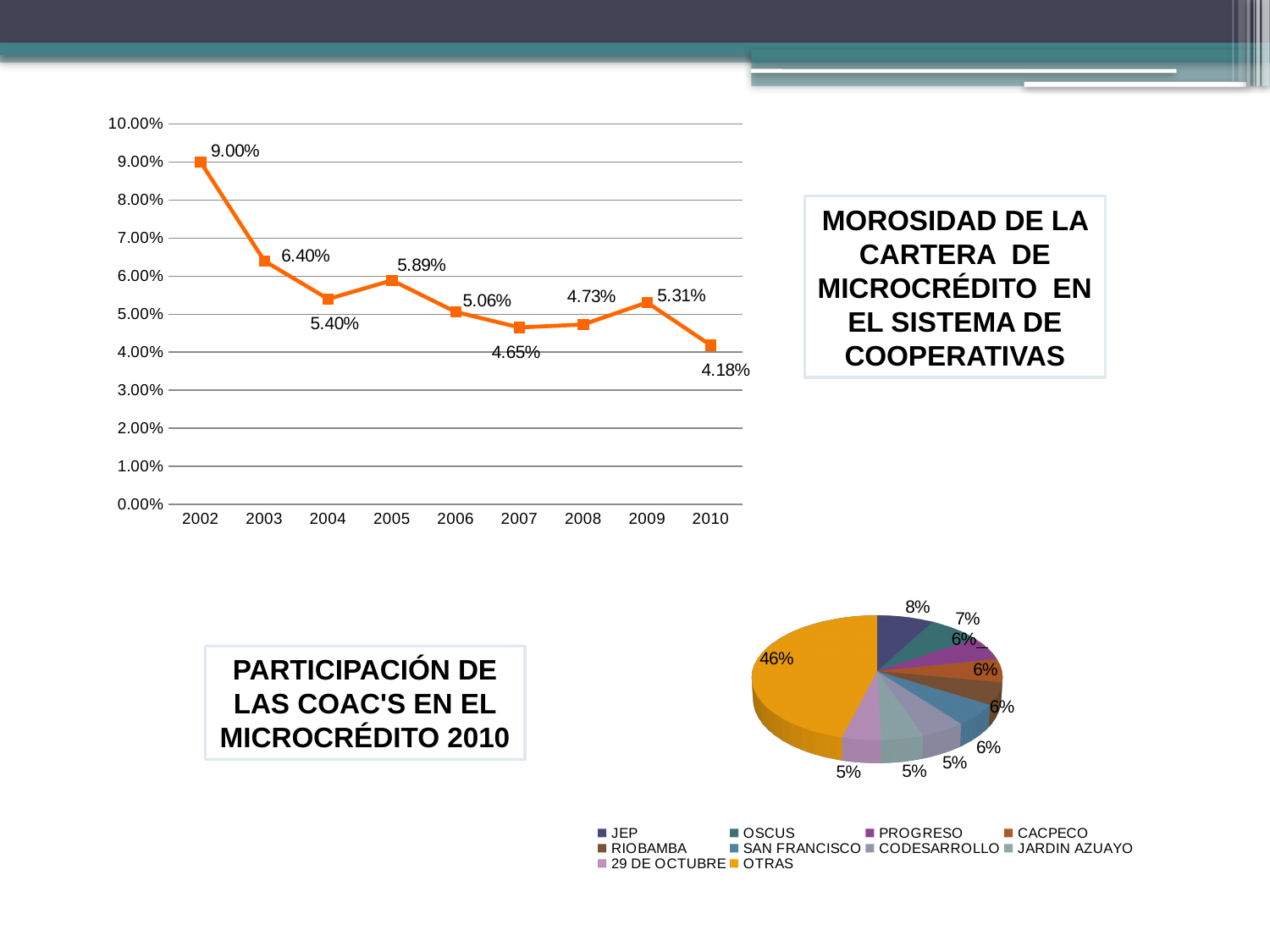
In the line chart on the left, what is the difference between the values for 2002 and 2003? 2.60% In the pie chart on the right, what share does OTRAS have? 46% In the line chart on the left, which is larger, the value for 2005 or the value for 2006? 2005 In the line chart on the left, which year has the lowest value? 2010 In the line chart on the left, which year has the highest value? 2002 In the line chart on the left, do the values generally rise or fall from 2002 to 2010? Fall In the line chart on the left, how many years are plotted on the x axis? 9 What kind of chart is the chart on the left of the slide? Line chart In the line chart on the left, what is the value for 2010? 4.18% How many entries does the legend of the pie chart on the right list? 10 In the line chart on the left, what is the value for 2007? 4.65% In the line chart on the left, what is the value for 2002? 9.00%